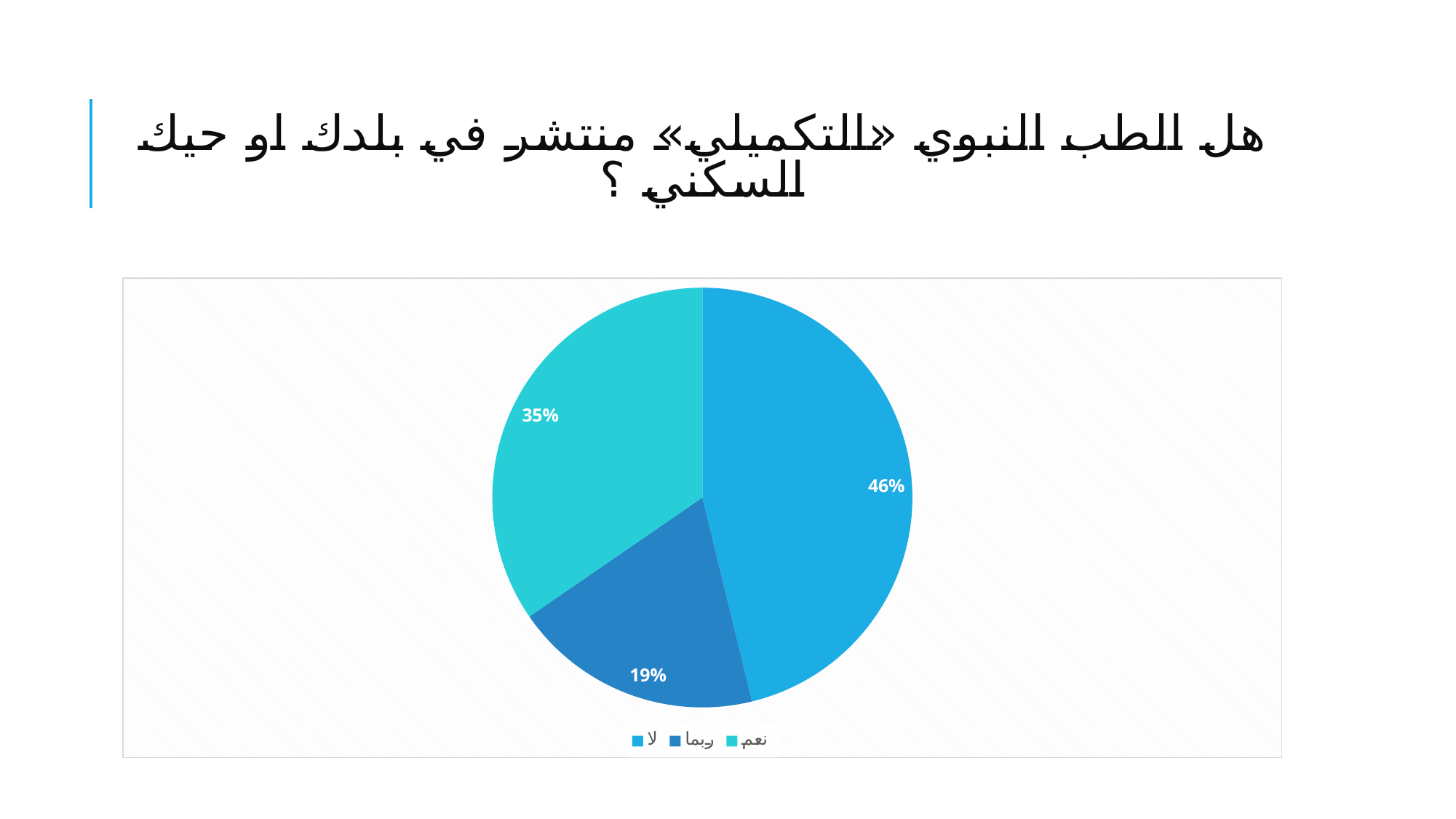
How many entries does the legend list? 3 Which slice is larger, نعم or ربما? نعم What is the difference in percentage points between the نعم slice and the ربما slice? 16 Which legend entry is shown in the darkest blue colour? ربما Which category has the largest slice of the pie? لا How many slices does the pie chart have? 3 What percentage of the pie is the slice for ربما? 19% Which category has the smallest slice of the pie? ربما What is the difference in percentage points between the لا slice and the نعم slice? 11 What percentage of the pie is the slice for لا? 46% What percentage of the pie is the slice for نعم? 35% What kind of chart is shown on the slide? pie chart